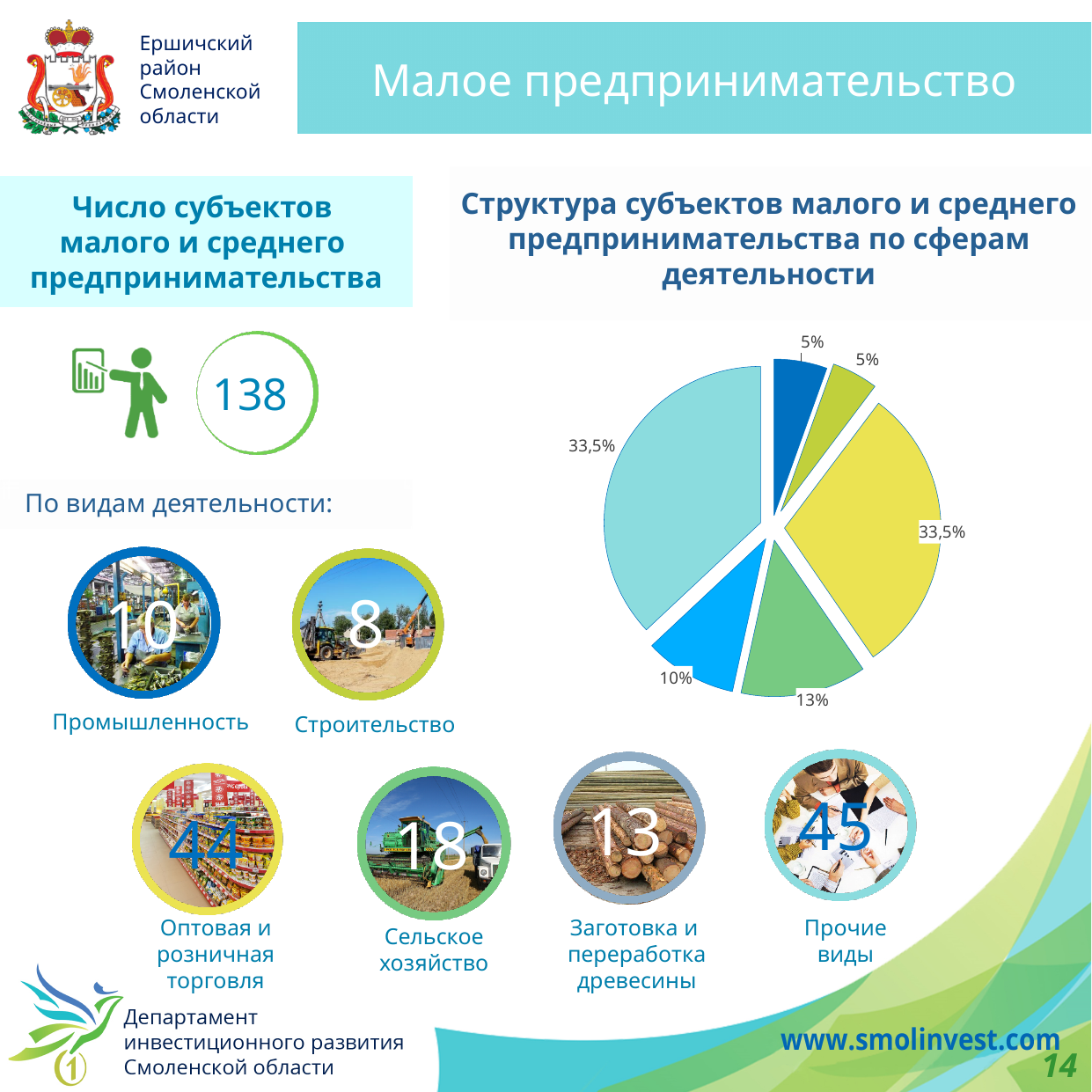
How many slices of the pie chart are labelled 5%? 2 What is the smallest percentage value labelled on the pie chart? 5% What percentage is labelled on the green slice at the bottom of the pie chart? 13% What is the difference in percentage points between the slice labelled 13% and the slice labelled 10% on the pie chart? 3 What kind of chart is shown under the title "Структура субъектов малого и среднего предпринимательства по сферам деятельности"? pie chart How many slices of the pie chart are labelled 33,5%? 2 What percentage is labelled on the bright blue slice at the bottom left of the pie chart? 10% What is the largest percentage value labelled on the pie chart? 33,5% Does the pie chart have a legend? No Which is larger on the pie chart: the slice labelled 13% or the slice labelled 10%? 13% How many slices does the pie chart have? 6 What is the title of the pie chart on the slide? Структура субъектов малого и среднего предпринимательства по сферам деятельности